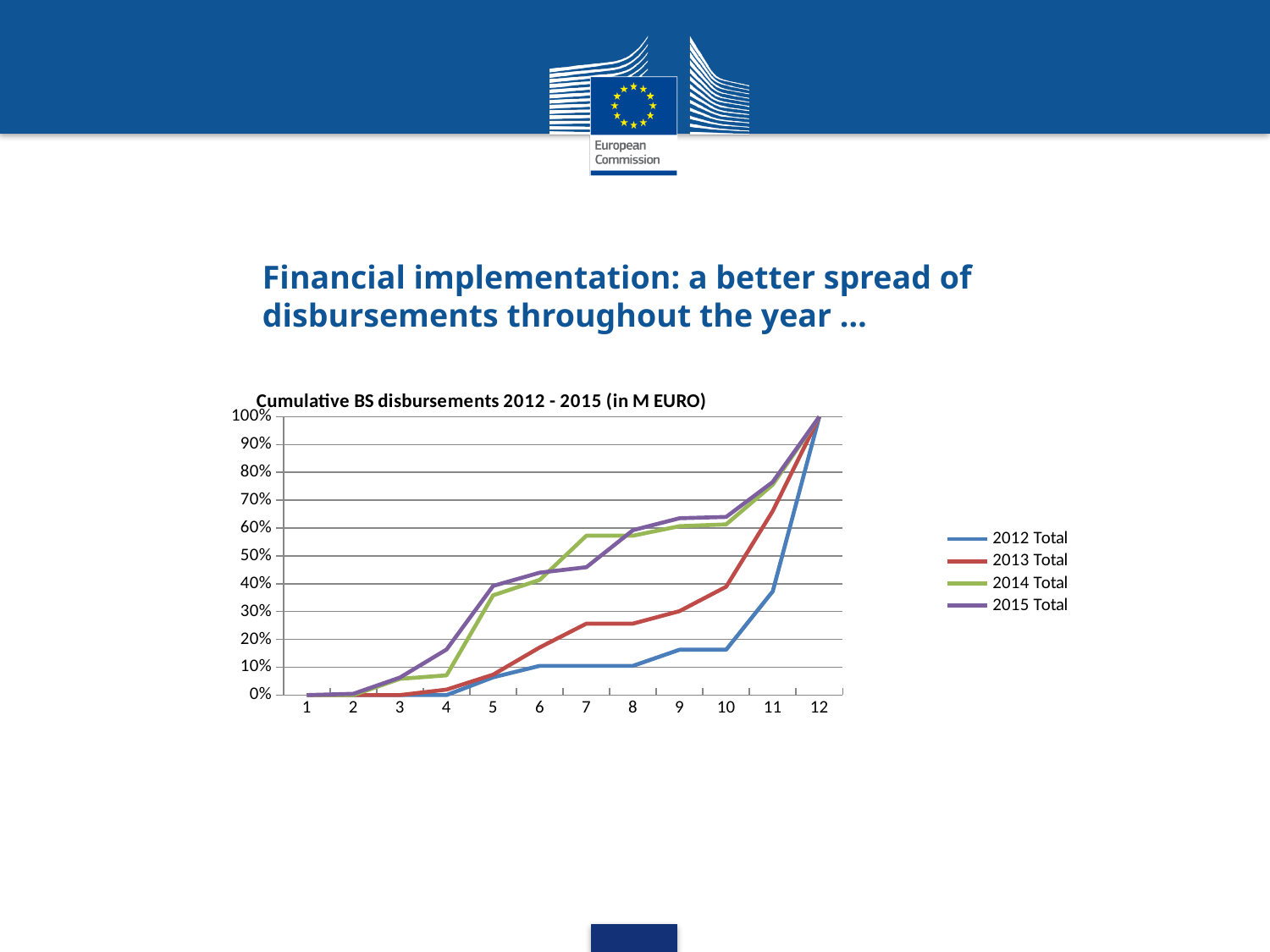
Is the value for 2015 Total at point 7 greater or less than 40%? greater Do the values of the 2013 Total series rise or fall along the x axis? rise What is the value of the 2012 Total series at point 12? 100% What is the value of the 2015 Total series at point 1? 0% What kind of chart is shown on the slide? line chart What is the title of the chart? Cumulative BS disbursements 2012 - 2015 (in M EURO) Is the value for 2013 Total at point 10 greater or less than 50%? less How many series does the legend list? 4 Which series has the highest value at point 7? 2014 Total Is the value for 2012 Total at point 10 greater or less than 20%? less How many points are there along the x axis? 12 At point 10, which is larger: 2015 Total or 2012 Total? 2015 Total